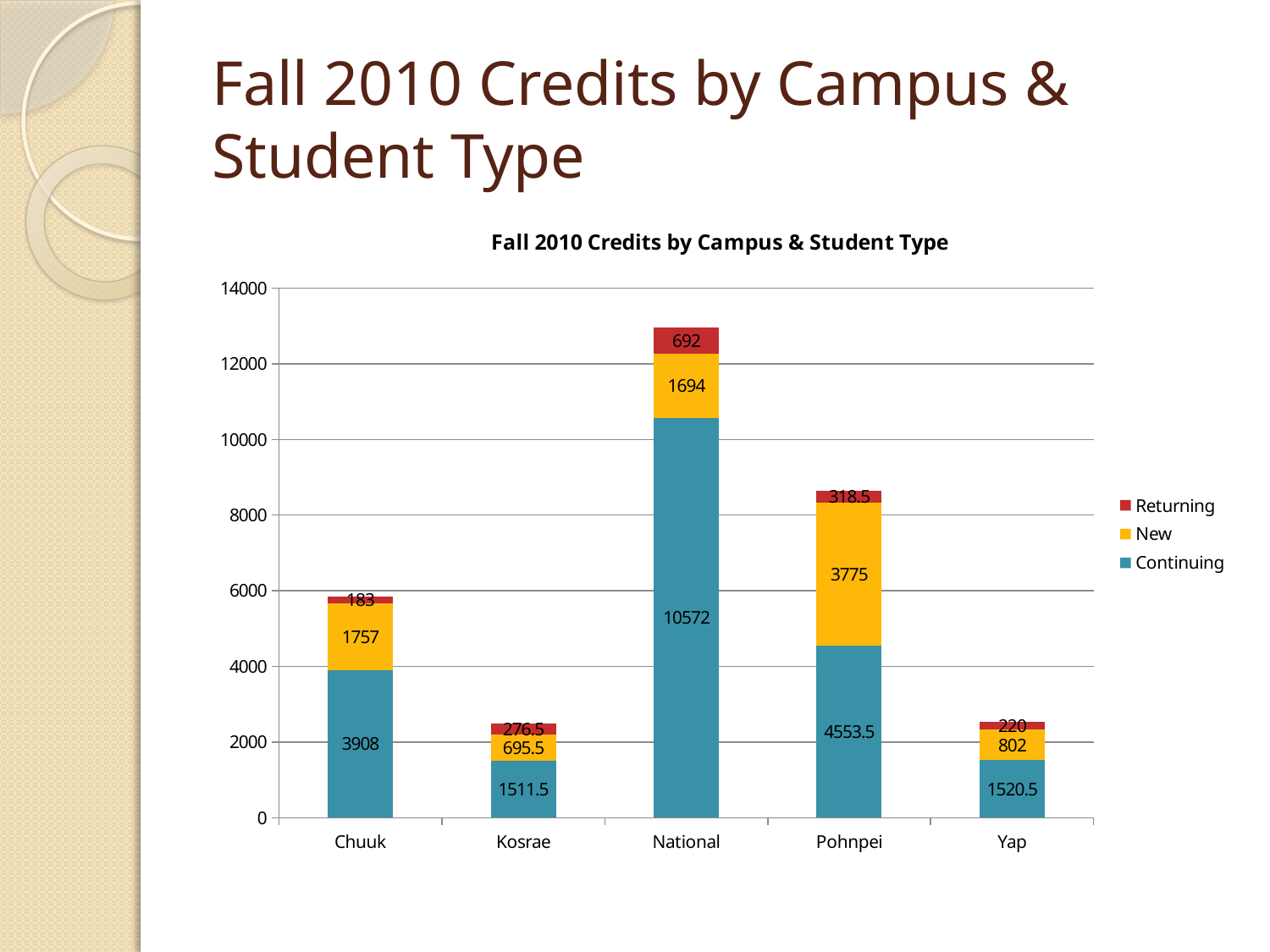
Which is larger, the Returning credits for Pohnpei or the Returning credits for Kosrae? Pohnpei How many series does the legend list? 3 What is the difference between the New credits for Chuuk and the New credits for National? 63 What is the New credits value for Pohnpei? 3775 What is the Continuing credits value for National? 10572 How many campuses are shown on the x axis? 5 What is the Returning credits value for Kosrae? 276.5 Which campus has the lowest New credits? Kosrae Is the total height of the National bar greater or less than 12000? greater What is the total credits for the Chuuk bar? 5848 Which campus has the highest Continuing credits? National What kind of chart is shown on the slide? Stacked bar chart